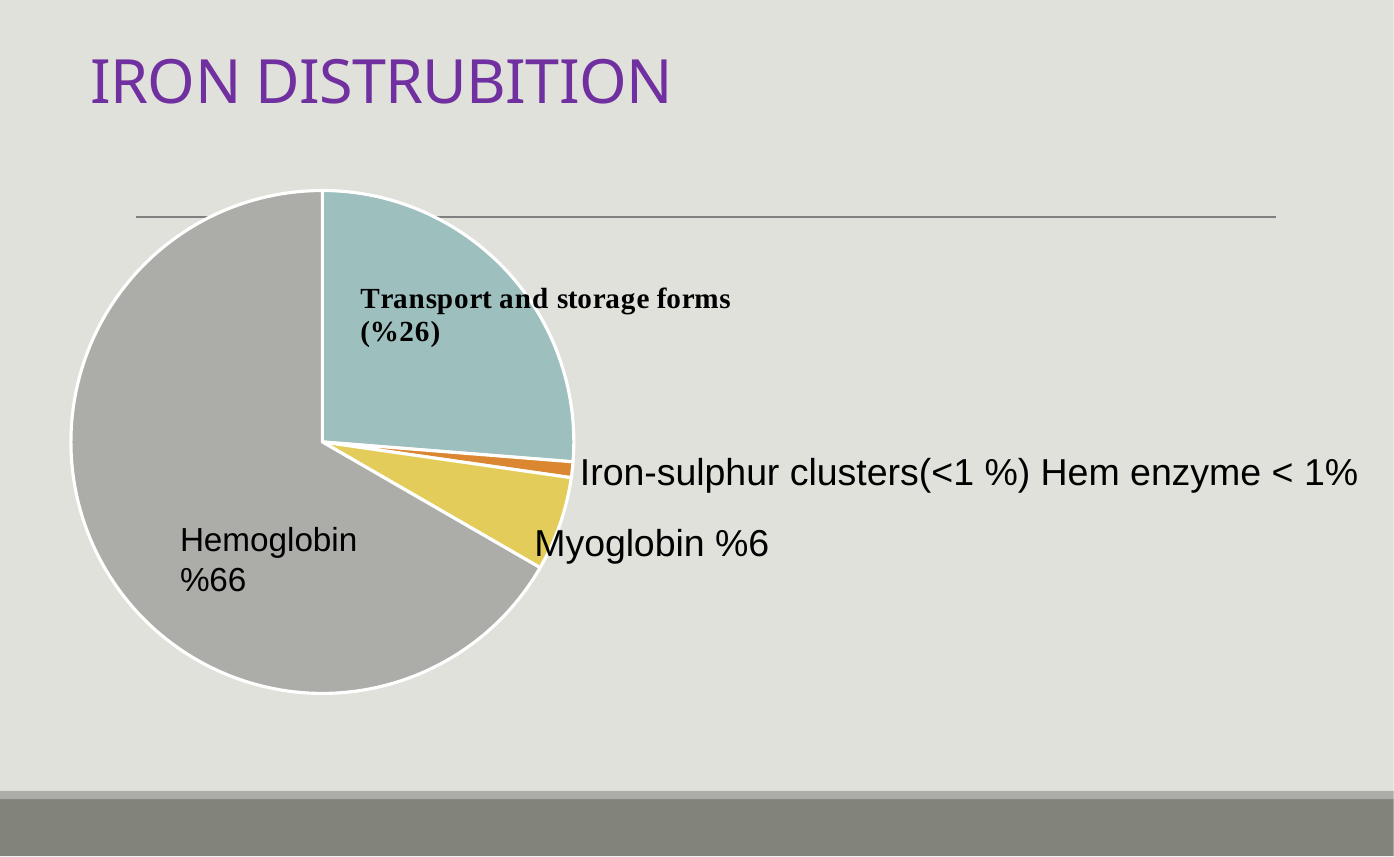
Which is larger in the pie chart, myoglobin or transport and storage forms? Transport and storage forms What is the title of the slide containing the pie chart? IRON DISTRUBITION What percentage does the pie chart give for transport and storage forms? %26 By how many percentage points does the hemoglobin share exceed the transport and storage forms share? 40 Which is larger in the pie chart, the hemoglobin slice or the transport and storage forms slice? Hemoglobin What percentage of iron is in hemoglobin according to the pie chart? %66 What percentage of iron is in myoglobin according to the pie chart? %6 Which category has the largest slice of the pie chart? Hemoglobin What colour is the hemoglobin slice in the pie chart? Gray What type of chart is shown on the slide? Pie chart By how many percentage points does the transport and storage forms share exceed the myoglobin share? 20